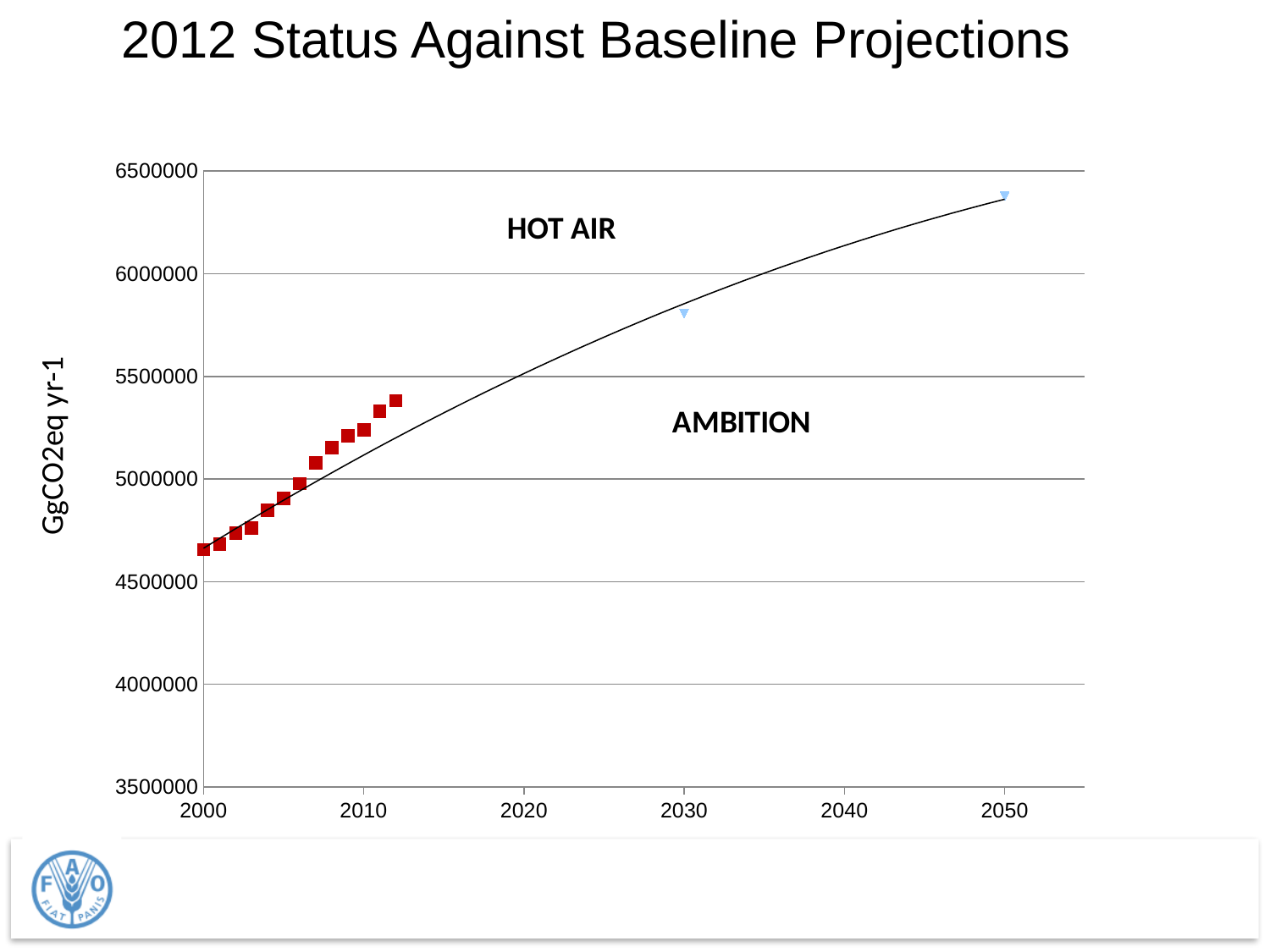
Which red square data point has the lowest value? 2000 Is the value of the blue triangle marker at 2030 greater or less than 6000000? less What is the label on the vertical axis of the chart? GgCO2eq yr-1 Is the value of the red square data point for 2012 greater or less than 5000000? greater Do the red square data points rise or fall from 2000 to 2012? rise Is the value of the red square data point for 2000 greater or less than 5000000? less Which has the higher value: the blue triangle marker at 2030 or the blue triangle marker at 2050? 2050 Which red square data point has the highest value? 2012 What is the title of the chart on the slide? 2012 Status Against Baseline Projections